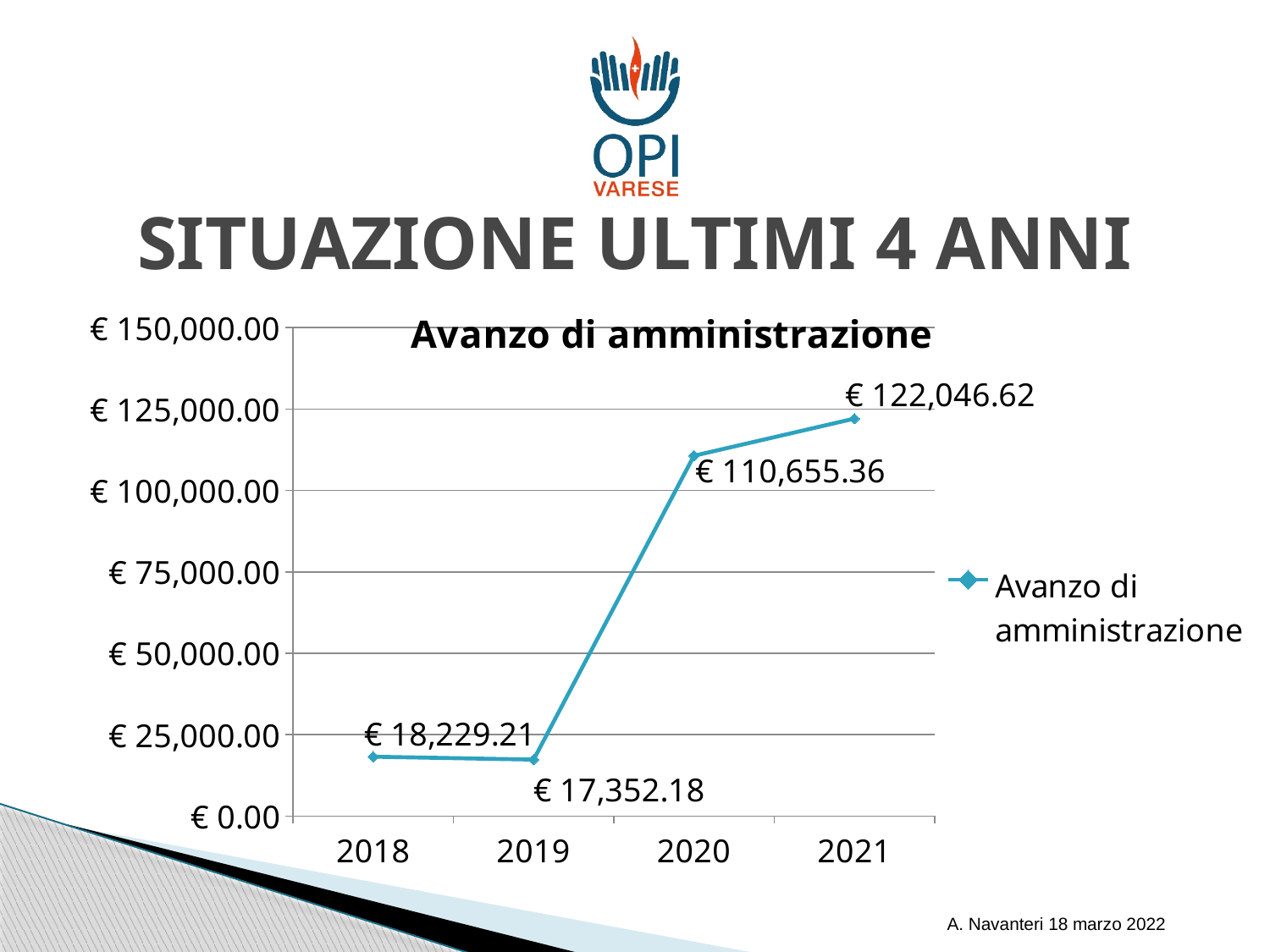
What is the title of the chart? Avanzo di amministrazione What is the value of Avanzo di amministrazione for 2019? € 17,352.18 Which year has the lowest Avanzo di amministrazione? 2019 What is the value of Avanzo di amministrazione for 2020? € 110,655.36 What is the value of Avanzo di amministrazione for 2018? € 18,229.21 What is the difference between the Avanzo di amministrazione in 2021 and in 2020? € 11,391.26 Which year has a larger Avanzo di amministrazione, 2018 or 2020? 2020 Which year has the highest Avanzo di amministrazione? 2021 How many years are plotted on the chart? 4 What type of chart is shown on the slide? line chart What is the difference between the Avanzo di amministrazione in 2020 and in 2019? € 93,303.18 What is the value of Avanzo di amministrazione for 2021? € 122,046.62